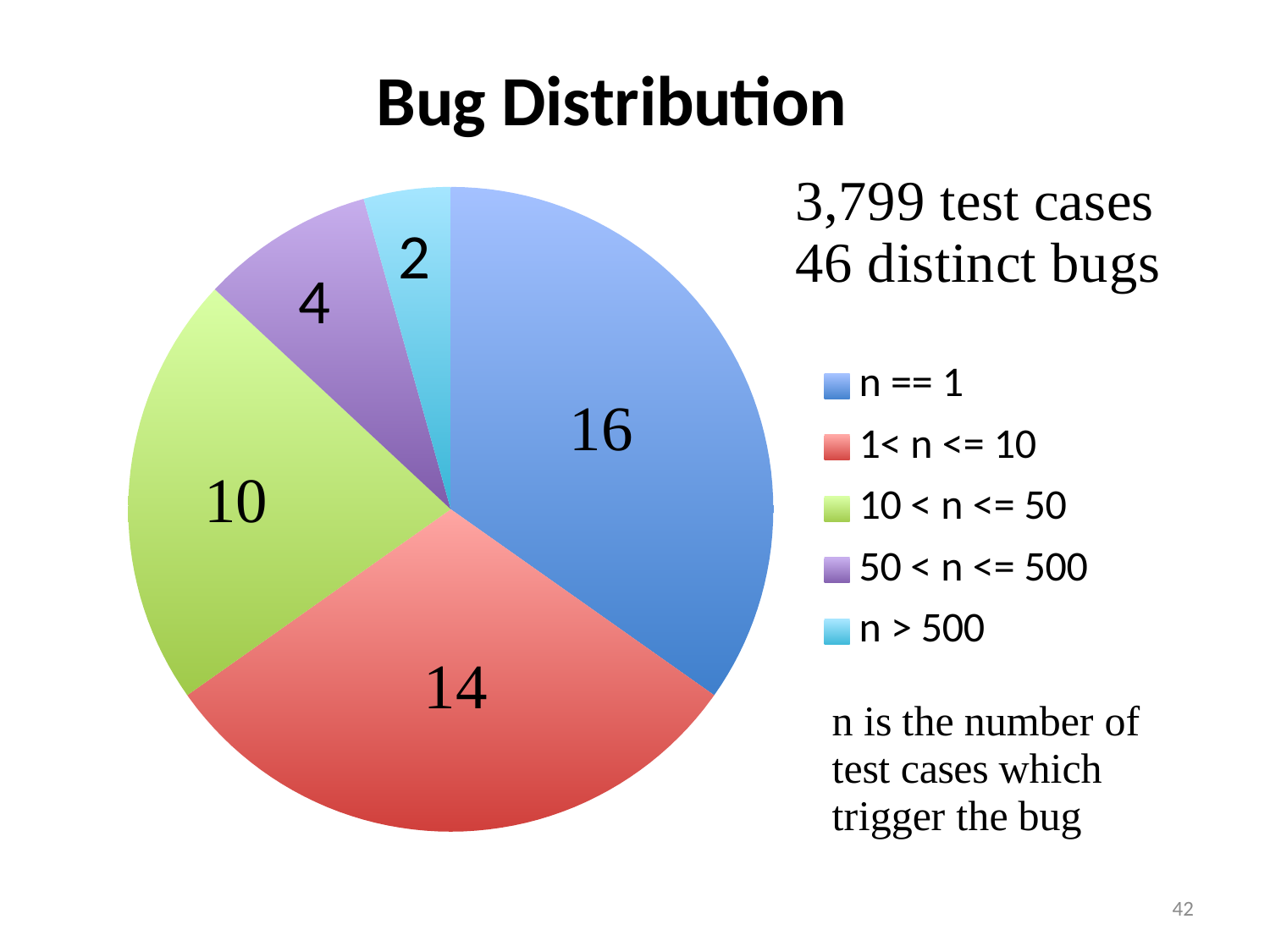
What kind of chart is shown on the slide? pie chart Which category has the largest slice? n == 1 What is the value for the n == 1 slice? 16 What is the value for the 10 < n <= 50 slice? 10 What is the value for the 50 < n <= 500 slice? 4 Which category has the smallest slice? n > 500 What is the difference between the n == 1 slice and the 10 < n <= 50 slice? 6 What is the title of the chart? Bug Distribution What is the value for the n > 500 slice? 2 How many slices does the pie chart have? 5 What is the value for the 1< n <= 10 slice? 14 Which is larger, the 1< n <= 10 slice or the 50 < n <= 500 slice? 1< n <= 10